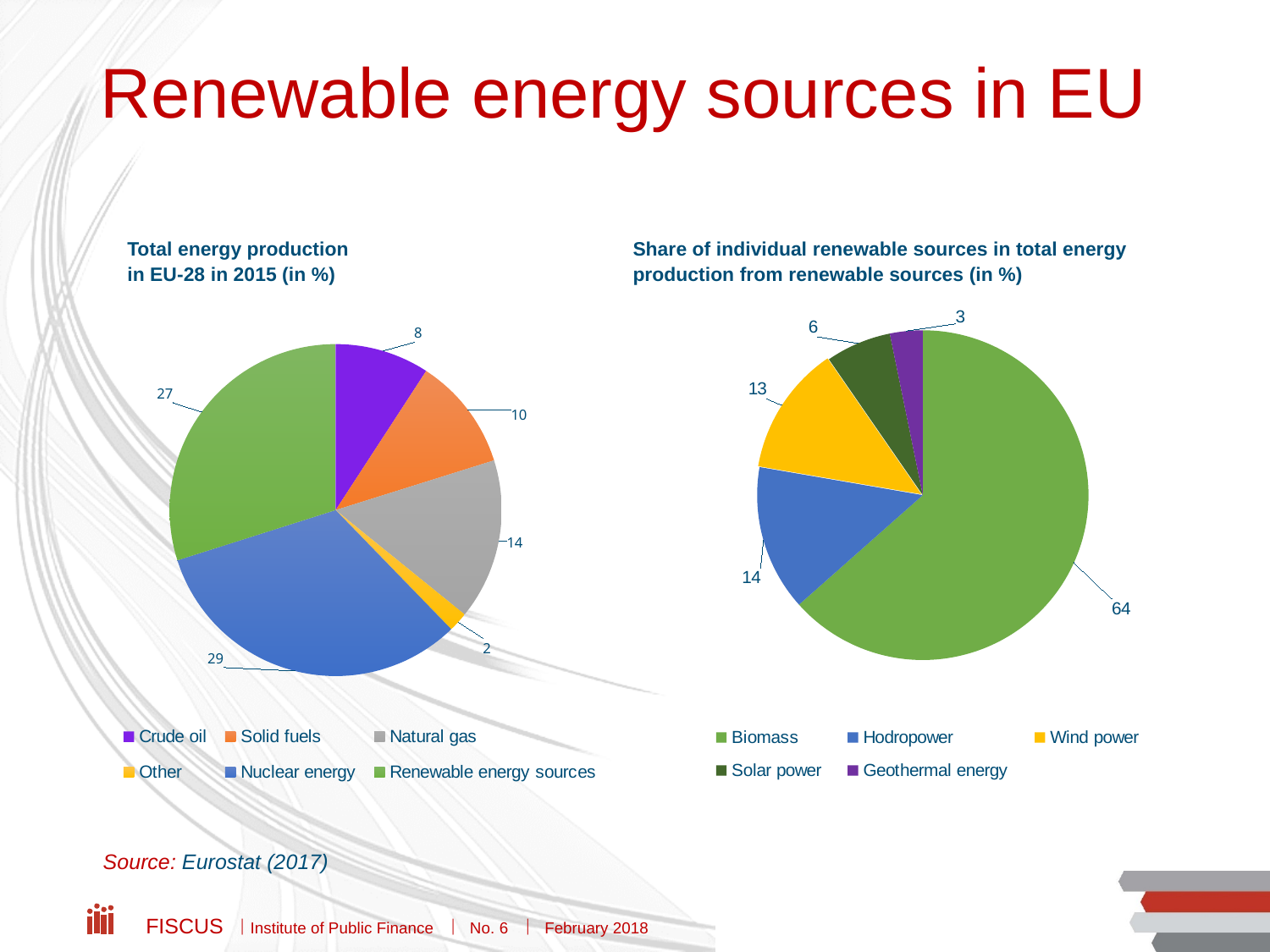
In the 'Total energy production in EU-28 in 2015' pie chart, what is the difference between Natural gas and Solid fuels? 4 In the 'Total energy production in EU-28 in 2015' pie chart, which is larger: Crude oil or Solid fuels? Solid fuels In the 'Total energy production in EU-28 in 2015' pie chart, how many categories are shown? 6 In the 'Share of individual renewable sources' pie chart, what is the value for Biomass? 64 In the 'Total energy production in EU-28 in 2015' pie chart, what is the value for Nuclear energy? 29 In the 'Total energy production in EU-28 in 2015' pie chart, which category has the smallest share? Other In the 'Share of individual renewable sources' pie chart, what is the difference between Biomass and Hodropower? 50 What type of chart is used on the right side of the slide? Pie chart In the 'Share of individual renewable sources' pie chart, what is the value for Wind power? 13 In the 'Total energy production in EU-28 in 2015' pie chart, what is the value for Renewable energy sources? 27 In the 'Share of individual renewable sources' pie chart, how many sources are listed in the legend? 5 In the 'Share of individual renewable sources' pie chart, which source has the smallest share? Geothermal energy